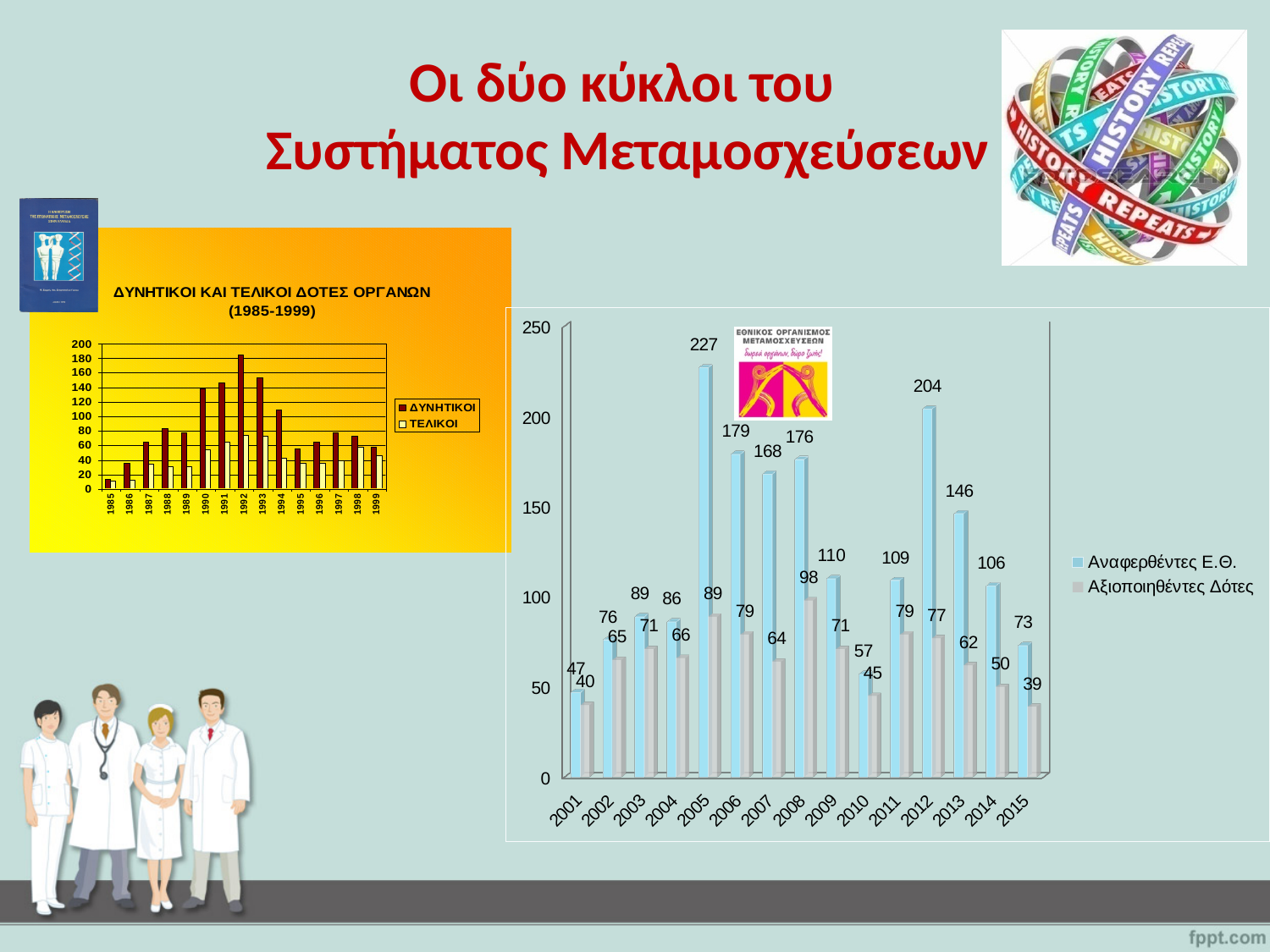
In the right-hand chart (2001–2015), how many series does the legend list? 2 In the right-hand chart (2001–2015), what is the difference between Αναφερθέντες Ε.Θ. and Αξιοποιηθέντες Δότες in 2012? 127 In the right-hand chart (2001–2015), which is larger: Αναφερθέντες Ε.Θ. in 2006 or in 2008? 2006 What kind of chart is the right-hand chart (2001–2015)? Bar chart In the right-hand chart (2001–2015), which year has the highest value for Αναφερθέντες Ε.Θ.? 2005 In the right-hand chart (2001–2015), what is the value of Αξιοποιηθέντες Δότες for 2008? 98 In the left-hand chart titled ΔΥΝΗΤΙΚΟΙ ΚΑΙ ΤΕΛΙΚΟΙ ΔΟΤΕΣ ΟΡΓΑΝΩΝ (1985-1999), is the ΔΥΝΗΤΙΚΟΙ value for 1992 greater or less than 140? greater In the left-hand chart titled ΔΥΝΗΤΙΚΟΙ ΚΑΙ ΤΕΛΙΚΟΙ ΔΟΤΕΣ ΟΡΓΑΝΩΝ (1985-1999), which year has the highest ΔΥΝΗΤΙΚΟΙ value? 1992 In the right-hand chart (2001–2015), what is the value of Αναφερθέντες Ε.Θ. for 2005? 227 In the right-hand chart (2001–2015), how many years are shown on the x axis? 15 In the left-hand chart titled ΔΥΝΗΤΙΚΟΙ ΚΑΙ ΤΕΛΙΚΟΙ ΔΟΤΕΣ ΟΡΓΑΝΩΝ (1985-1999), what are the two series listed in the legend? ΔΥΝΗΤΙΚΟΙ and ΤΕΛΙΚΟΙ In the right-hand chart (2001–2015), which year has the lowest value for Αξιοποιηθέντες Δότες? 2015